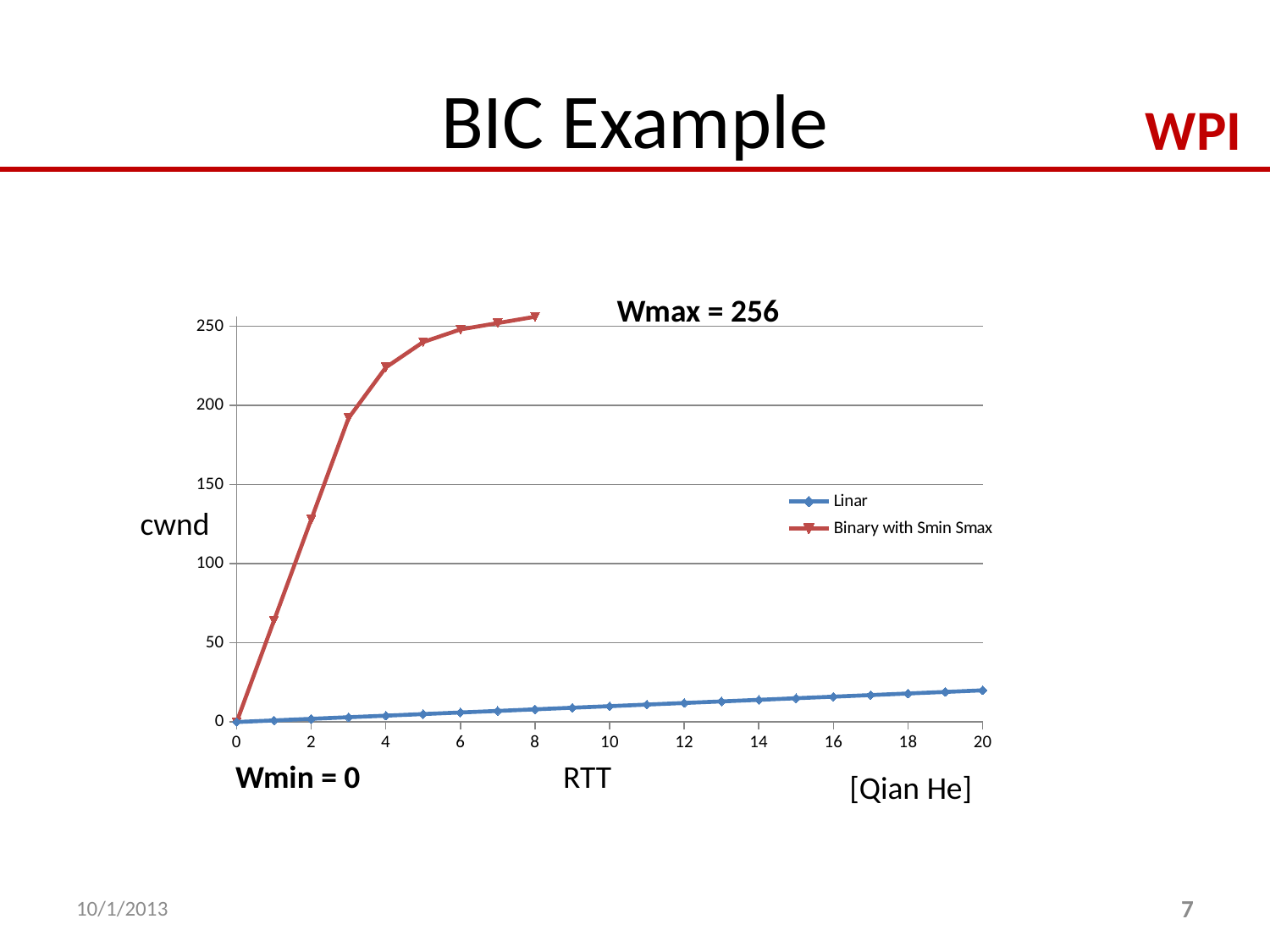
Is the value of the Binary with Smin Smax series at RTT 4 greater or less than 200? greater Is the value of the Linar series at RTT 20 greater or less than 50? less How many series does the legend list? 2 Is the value of the Binary with Smin Smax series at RTT 1 greater or less than 50? greater What is the label of the y axis? cwnd At RTT 4, which series has the higher cwnd value, Linar or Binary with Smin Smax? Binary with Smin Smax What kind of chart is shown on the slide? line chart Does the Linar series rise or fall as RTT increases from 0 to 20? rise How many data points are plotted for the Binary with Smin Smax series? 9 How many data points are plotted for the Linar series? 21 What are the two series named in the legend? Linar; Binary with Smin Smax